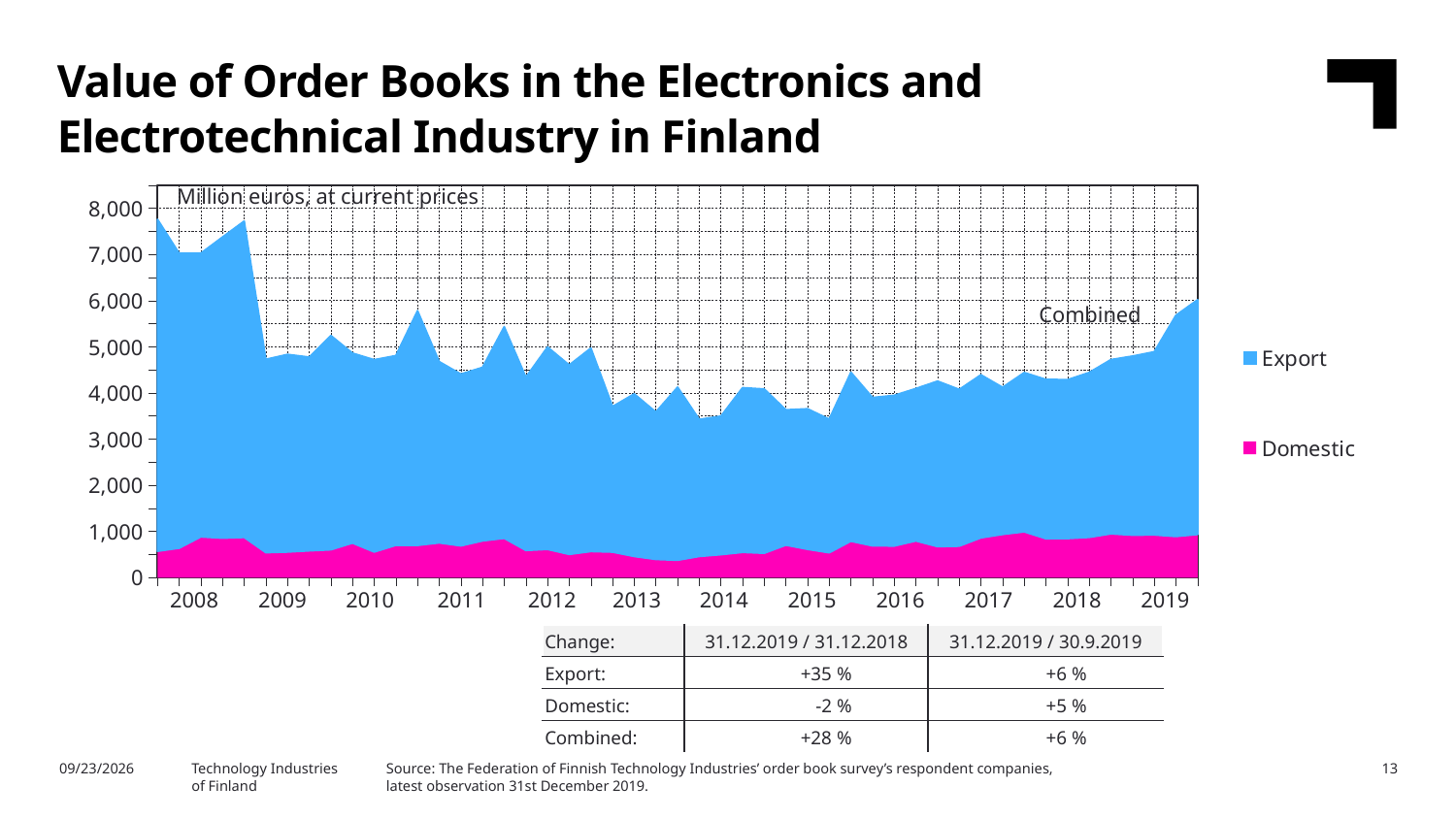
Which series, Export or Domestic, is larger in 2019? Export Is the combined value at the start of 2008 greater or less than 7,000? greater How many series does the chart's legend list? 2 How many years are labelled on the x axis of the chart? 12 Is the combined value at the end of 2019 greater or less than 5,000? greater In which year does the combined value of order books reach its highest level? 2008 Is the Domestic value in 2014 greater or less than 1,000? less What kind of chart is shown on the slide? Stacked area chart What unit is stated for the values on the chart? Million euros, at current prices Which two series are listed in the chart's legend? Export and Domestic Does the combined value of order books rise or fall between 2008 and 2014? fall